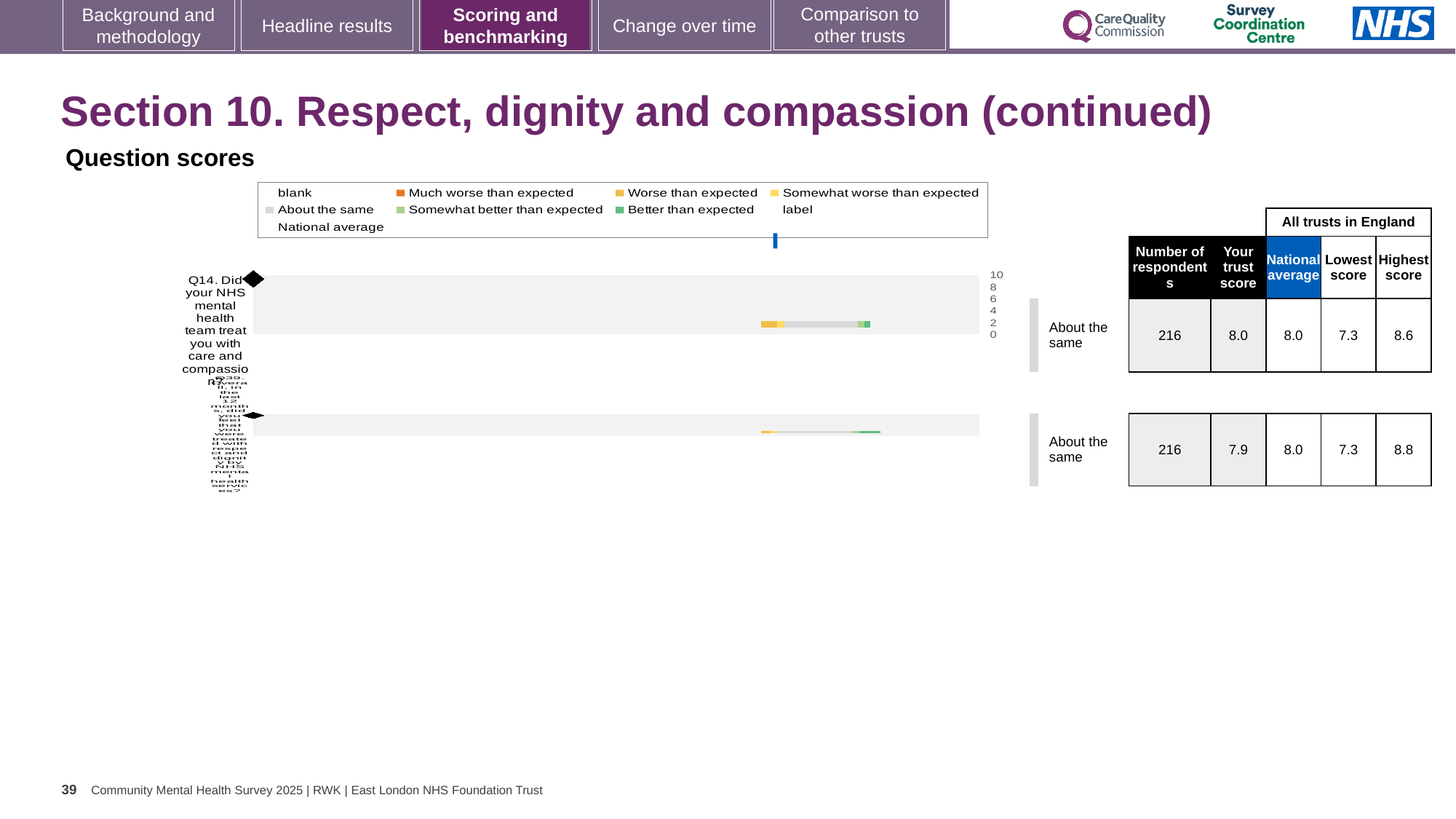
What is the trust score for Q14 (care and compassion)? 8.0 What is the highest value shown on the score axis of the chart? 10 What is the highest score among all trusts in England for Q39? 8.8 What kind of chart is used to show the question scores on this slide? bar chart How many questions are plotted in the question scores chart? 2 Which question has the higher trust score, Q14 or Q39? Q14 What is the lowest score among all trusts in England for Q14? 7.3 How many respondents answered Q14? 216 What is the trust score for Q39 (respect and dignity)? 7.9 What is the difference between the highest and lowest trust scores in England for Q39? 1.5 Which benchmark category is Q14 placed in? About the same What is the national average score for Q14? 8.0